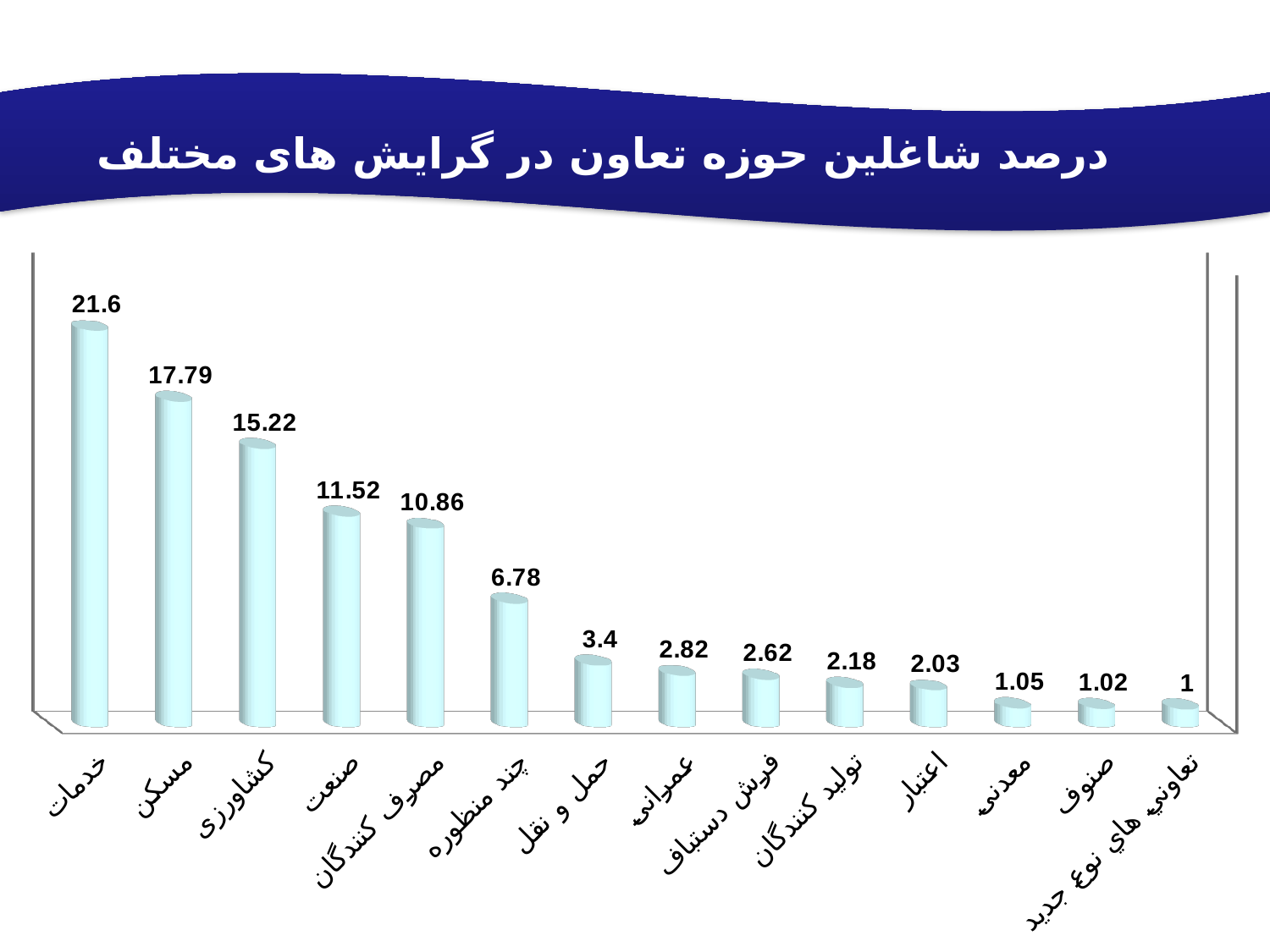
What kind of chart is shown on the slide? Bar chart What is the value for فرش دستباف? 2.62 Do the values rise or fall from left to right along the x axis? Fall What is the difference between the values for صنعت and مصرف کنندگان? 0.66 What is the difference between the values for خدمات and مسکن? 3.81 What is the value for مسکن? 17.79 What is the value for خدمات? 21.6 Which category has the highest value? خدمات What is the value for چند منظوره? 6.78 How many categories are shown in the chart? 14 Which is larger, the value for کشاورزی or the value for صنعت? کشاورزی Which category has the lowest value? تعاونی های نوع جدید